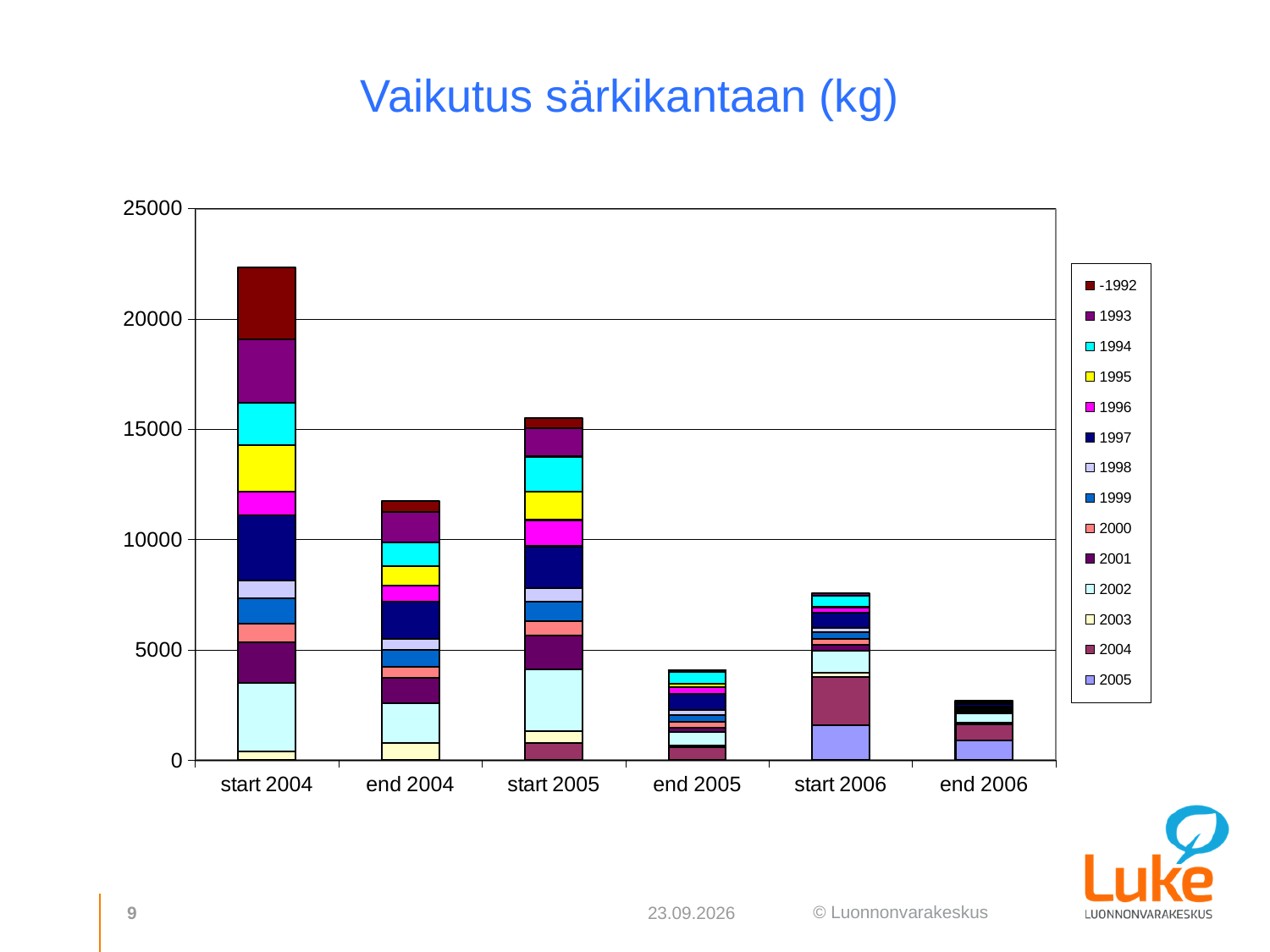
What kind of chart is shown on the slide? Stacked bar chart How many series does the legend list? 14 How many categories are shown on the x axis? 6 Which category has the lowest total stacked bar? end 2006 Do the totals for the 'start' categories rise or fall from start 2004 to start 2006? fall What is the title of the chart? Vaikutus särkikantaan (kg) Is the total for end 2004 greater or less than 10000? greater Which has the larger total, start 2006 or end 2006? start 2006 Is the total for start 2004 greater or less than 20000? greater Which category has the highest total stacked bar? start 2004 Is the total for end 2005 greater or less than 5000? less Which has the larger total, start 2005 or end 2004? start 2005